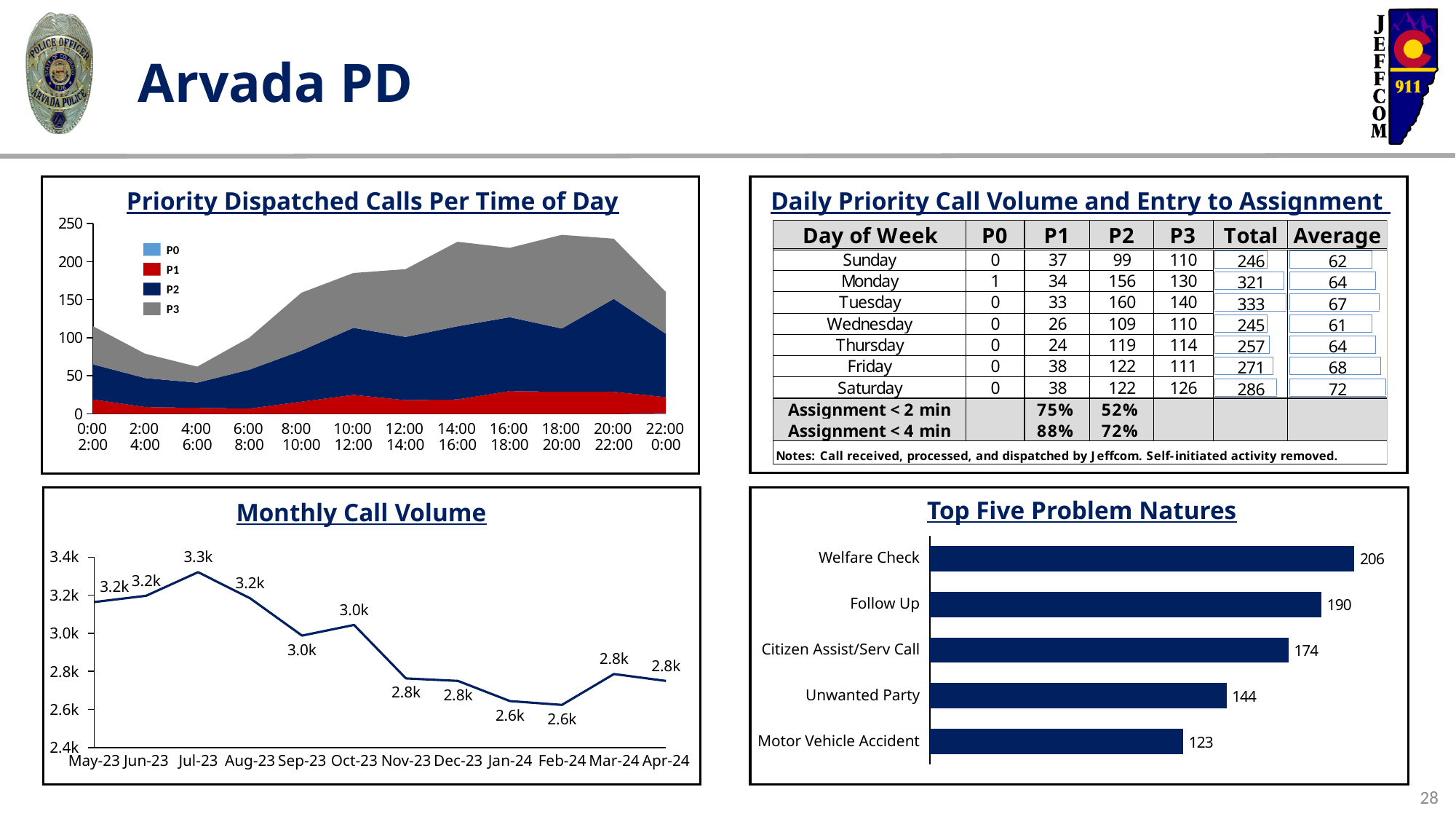
In the Top Five Problem Natures chart, what is the difference between Follow Up and Unwanted Party? 46 In the Top Five Problem Natures chart, which is larger: Citizen Assist/Serv Call or Unwanted Party? Citizen Assist/Serv Call In the Monthly Call Volume chart, which month has the highest call volume? Jul-23 In the Monthly Call Volume chart, does the call volume rise or fall from Jul-23 to Jan-24? fall In the Monthly Call Volume chart, what is the value for Jul-23? 3.3k In the Top Five Problem Natures chart, what is the value for Welfare Check? 206 In the Top Five Problem Natures chart, what is the value for Motor Vehicle Accident? 123 In the Top Five Problem Natures chart, which problem nature has the lowest value? Motor Vehicle Accident In the Priority Dispatched Calls Per Time of Day chart, is the total stacked value for the 18:00-20:00 period greater or less than 200? greater What kind of chart is the Top Five Problem Natures chart? bar chart How many months are plotted in the Monthly Call Volume chart? 12 How many series does the legend of the Priority Dispatched Calls Per Time of Day chart list? 4